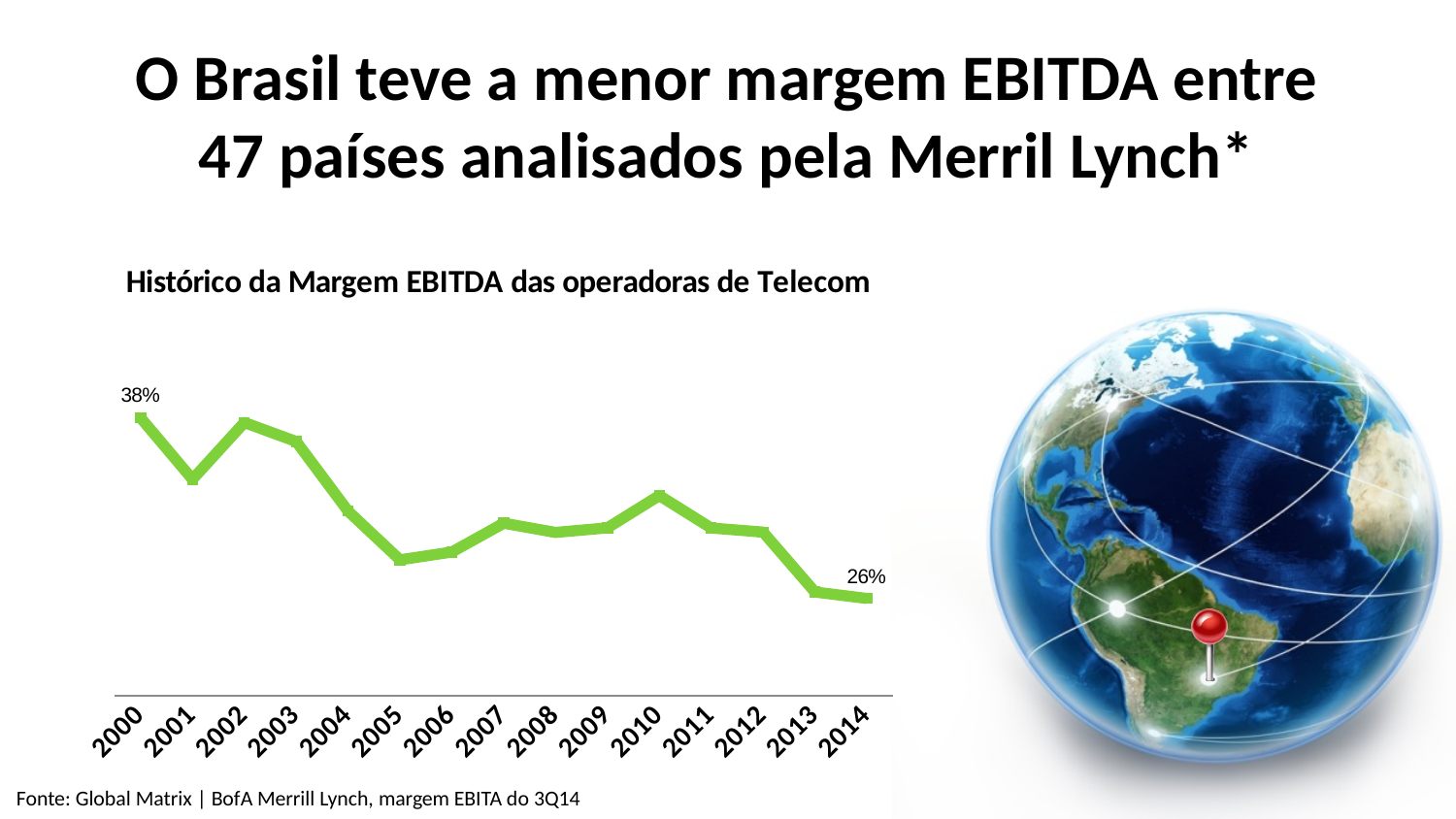
Which year has the higher EBITDA margin, 2005 or 2010? 2010 Which year has the higher EBITDA margin, 2000 or 2014? 2000 What kind of chart is used to show the EBITDA margin history? Line chart What colour is the line in the chart? Green What is the EBITDA margin value shown for 2014? 26% Which year has the higher EBITDA margin, 2001 or 2004? 2001 What is the EBITDA margin value shown for 2000? 38% What is the first year shown on the x axis of the chart? 2000 Does the EBITDA margin generally rise or fall from 2000 to 2014? Fall How many years are plotted on the x axis of the chart? 15 By how many percentage points did the EBITDA margin fall from 2000 to 2014? 12 percentage points What is the title of the chart? Histórico da Margem EBITDA das operadoras de Telecom